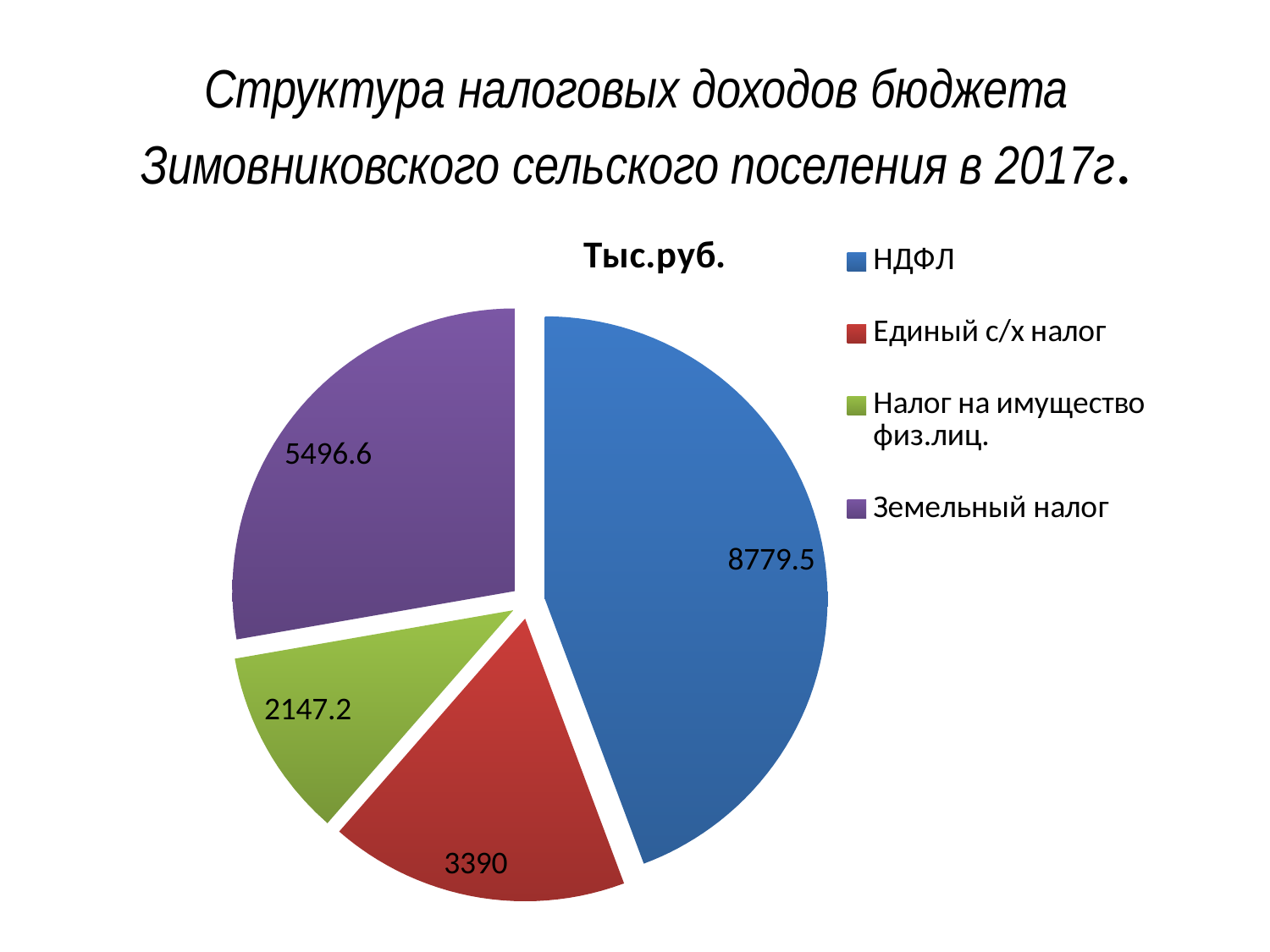
What is the value for Единый с/х налог? 3390 What is the title shown above the pie chart? Тыс.руб. What is the difference between the values for НДФЛ and Земельный налог? 3282.9 What kind of chart is shown on the slide? Pie chart What is the value for Земельный налог? 5496.6 Which category has the smallest slice of the pie? Налог на имущество физ.лиц. How many categories does the pie chart show? 4 What is the value for Налог на имущество физ.лиц.? 2147.2 What is the value for НДФЛ? 8779.5 Which is larger, Единый с/х налог or Налог на имущество физ.лиц.? Единый с/х налог What is the total of all slices in the pie chart? 19813.3 Which category has the largest slice of the pie? НДФЛ